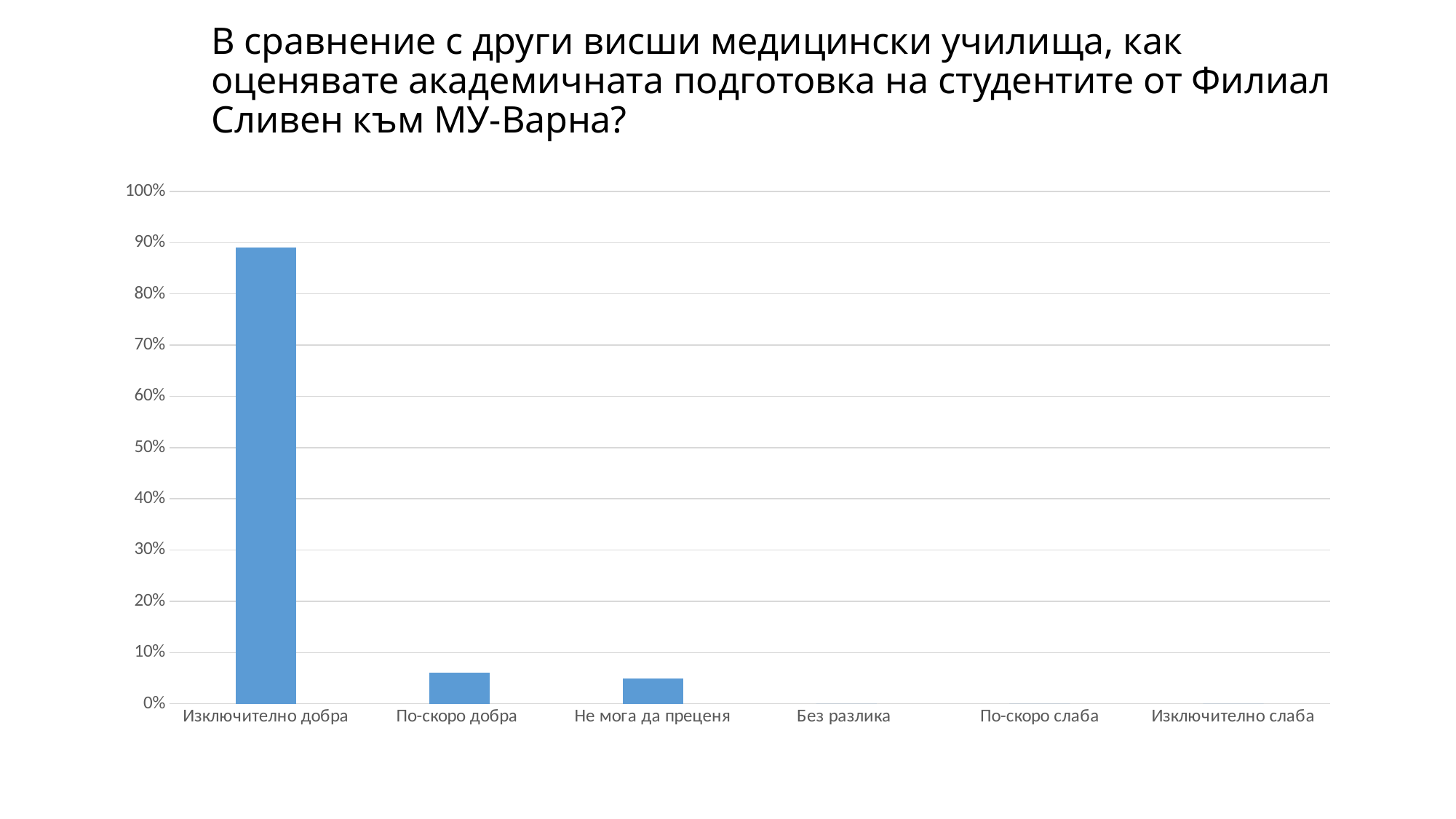
Is the value for По-скоро добра greater or less than 10%? less Which is larger, the value for Изключително добра or the value for По-скоро добра? Изключително добра Is the value for Не мога да преценя greater or less than 10%? less What kind of chart is shown on the slide? bar chart What is the highest value shown on the y axis of the chart? 100% Which is larger, the value for Не мога да преценя or the value for Без разлика? Не мога да преценя Is the value for Изключително добра greater or less than 80%? greater How many categories are shown on the x axis of the chart? 6 Which category has the highest value in the chart? Изключително добра What colour are the bars in the chart? blue